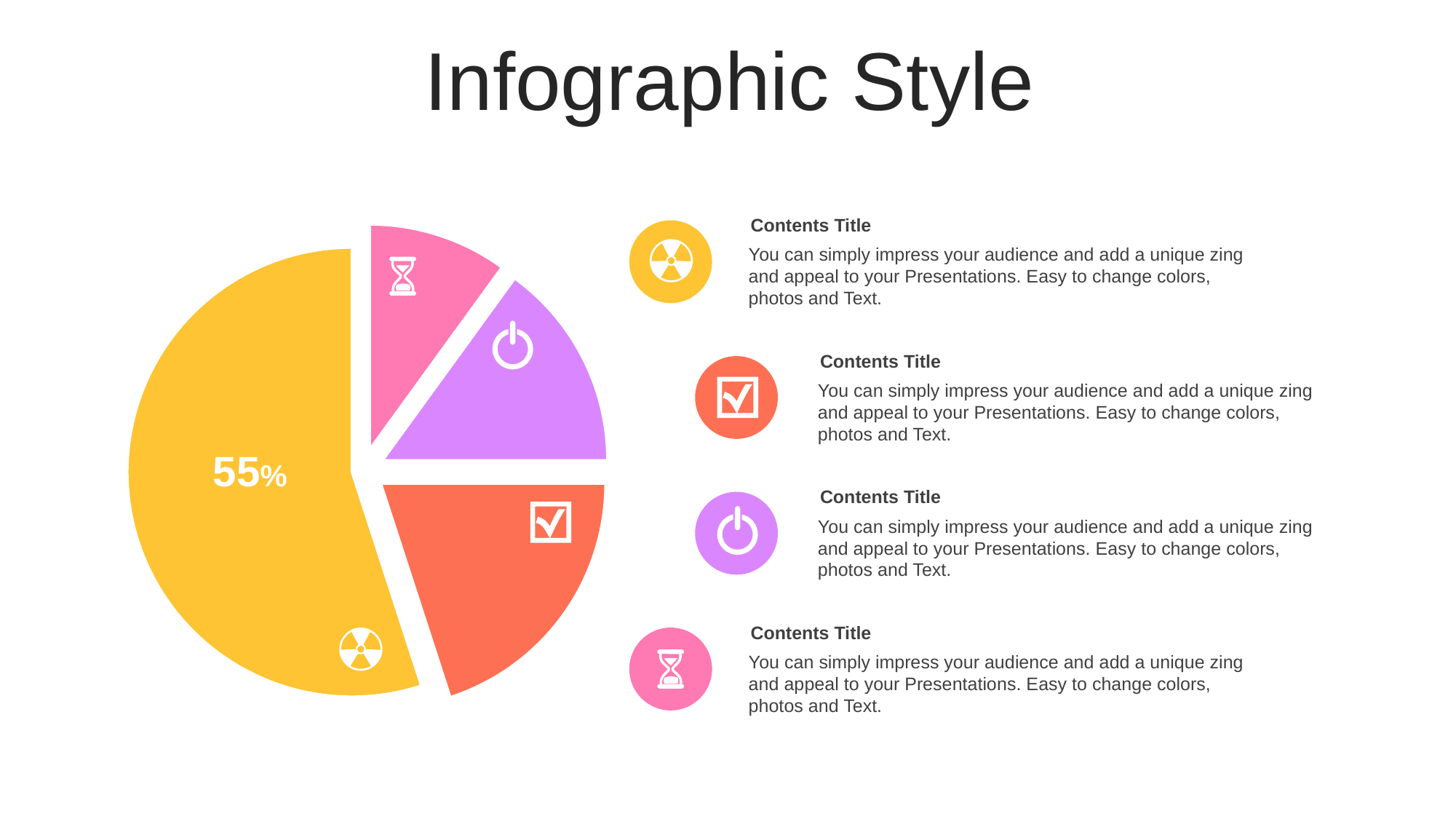
What kind of chart is shown on the slide? pie chart Which slice of the pie chart is the largest? the yellow slice How many slices does the pie chart have? 4 What colour is the slice labelled 55%? yellow Which is larger, the yellow slice or the orange slice? the yellow slice What is the title of the slide containing the pie chart? Infographic Style What percentage is printed on the yellow slice of the pie chart? 55% Which is larger, the purple slice or the pink slice? the purple slice Is the yellow slice greater or less than 50% of the pie? greater What share of the pie does the yellow slice represent? 55% Which slice of the pie chart is the smallest? the pink slice